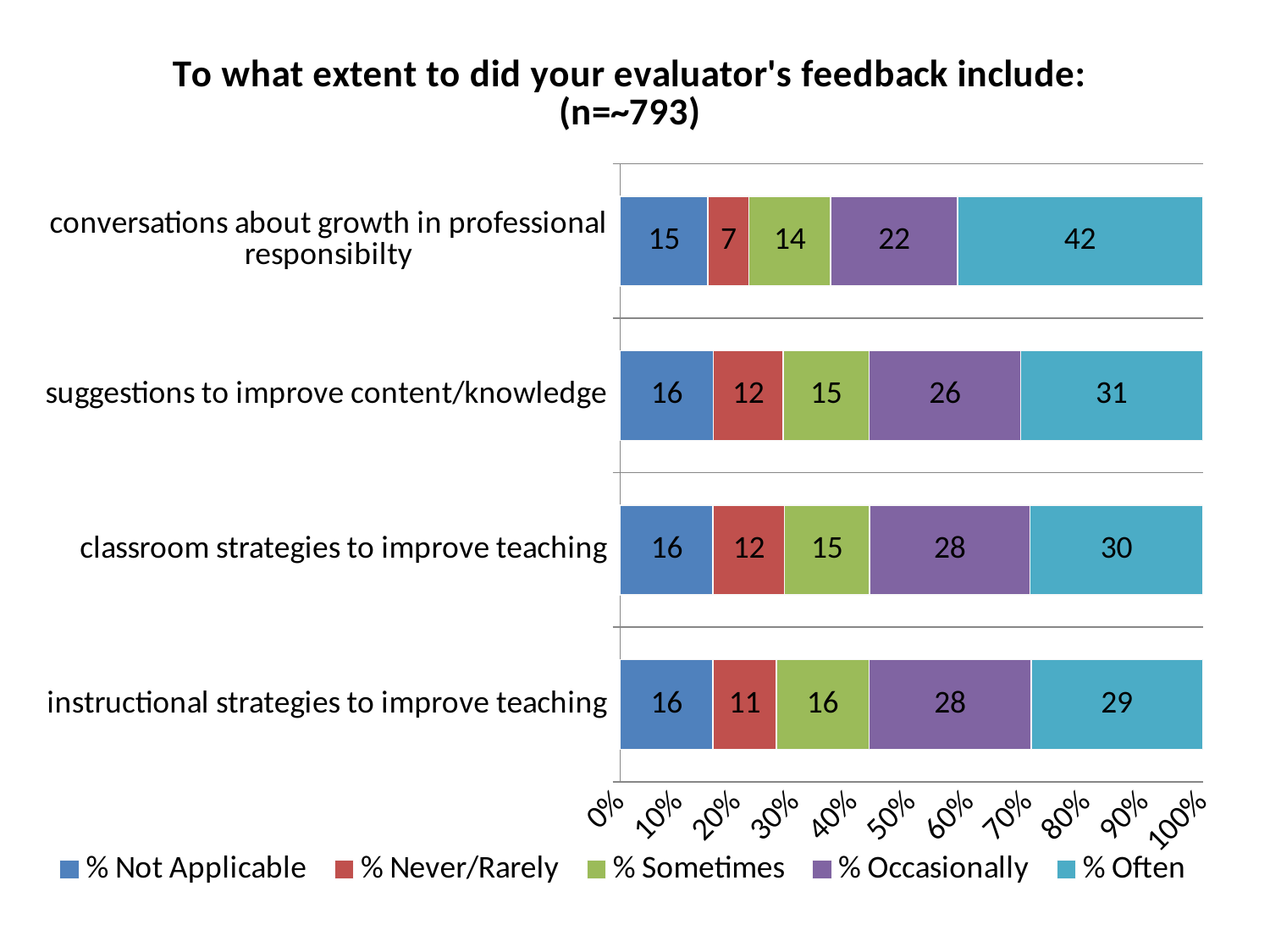
How many series does the legend list? 5 What is the % Often value for "conversations about growth in professional responsibilty"? 42 Which category has the lowest % Never/Rarely value? conversations about growth in professional responsibilty Which colour represents % Often in the chart? light blue Which category has the highest % Often value? conversations about growth in professional responsibilty What is the % Never/Rarely value for "instructional strategies to improve teaching"? 11 What is the % Occasionally value for "suggestions to improve content/knowledge"? 26 What kind of chart is shown on the slide? stacked bar chart What is the difference between the % Often values for "conversations about growth in professional responsibilty" and "instructional strategies to improve teaching"? 13 What is the % Sometimes value for "classroom strategies to improve teaching"? 15 Which is larger: the % Occasionally value for "classroom strategies to improve teaching" or for "suggestions to improve content/knowledge"? classroom strategies to improve teaching How many categories are shown on the chart? 4